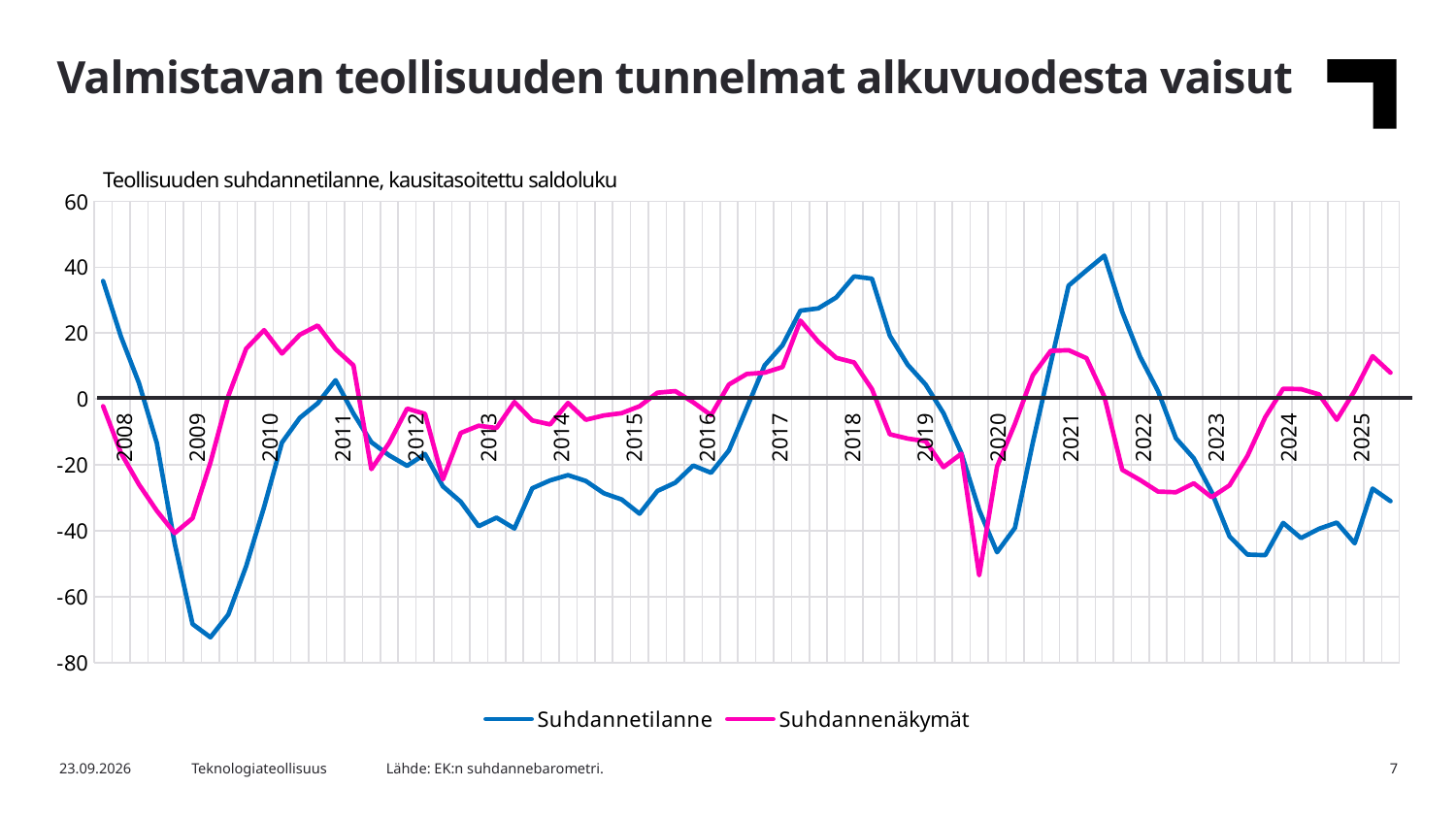
How many year labels are shown on the x axis? 18 What kind of chart is shown on the slide? line chart Around 2009, which series has the higher value, Suhdannetilanne or Suhdannenäkymät? Suhdannenäkymät What is the title of the chart? Teollisuuden suhdannetilanne, kausitasoitettu saldoluku What are the two series named in the legend? Suhdannetilanne and Suhdannenäkymät How many series does the legend list? 2 Around 2024, which series has the higher value, Suhdannetilanne or Suhdannenäkymät? Suhdannenäkymät Is the highest value of the Suhdannetilanne series (around 2021) greater or less than 40? greater Is the highest value of the Suhdannenäkymät series greater or less than 40? less Is the lowest value of the Suhdannetilanne series (around 2009) greater or less than -60? less